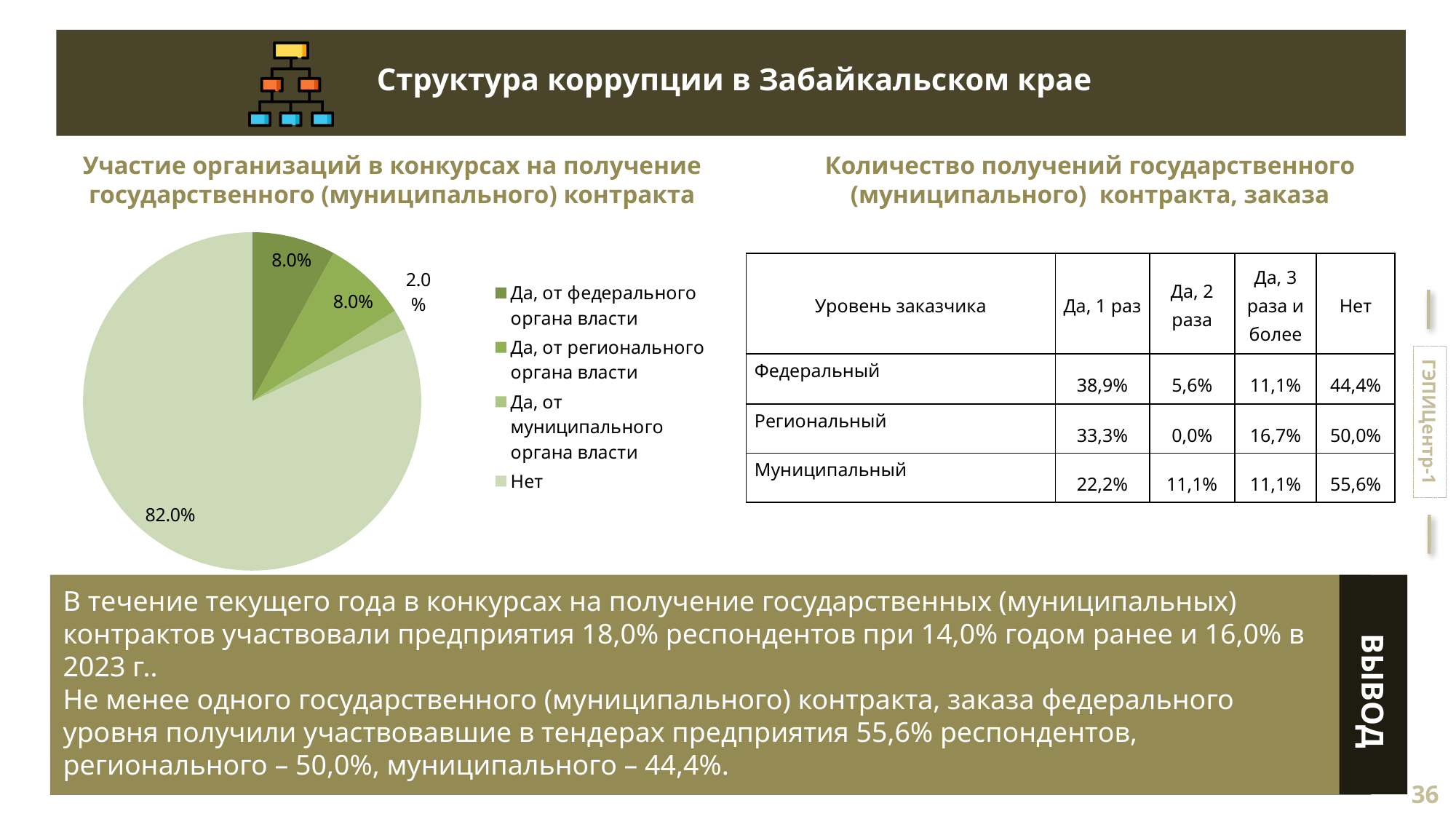
In the pie chart, what is the value for "Да, от федерального органа власти"? 8.0% In the pie chart, what is the value for "Да, от регионального органа власти"? 8.0% In the pie chart, which is larger: "Да, от регионального органа власти" or "Да, от муниципального органа власти"? Да, от регионального органа власти How many slices does the pie chart have? 4 How many entries does the legend of the pie chart list? 4 In the pie chart, what is the value for "Да, от муниципального органа власти"? 2.0% In the pie chart, what is the difference between the "Нет" slice and the "Да, от федерального органа власти" slice? 74.0% What kind of chart is shown under the title "Участие организаций в конкурсах на получение государственного (муниципального) контракта"? Pie chart Which category has the smallest slice in the pie chart? Да, от муниципального органа власти In the pie chart, what is the value for "Нет"? 82.0% Which category has the largest slice in the pie chart? Нет What is the combined share of all "Да" slices in the pie chart? 18.0%